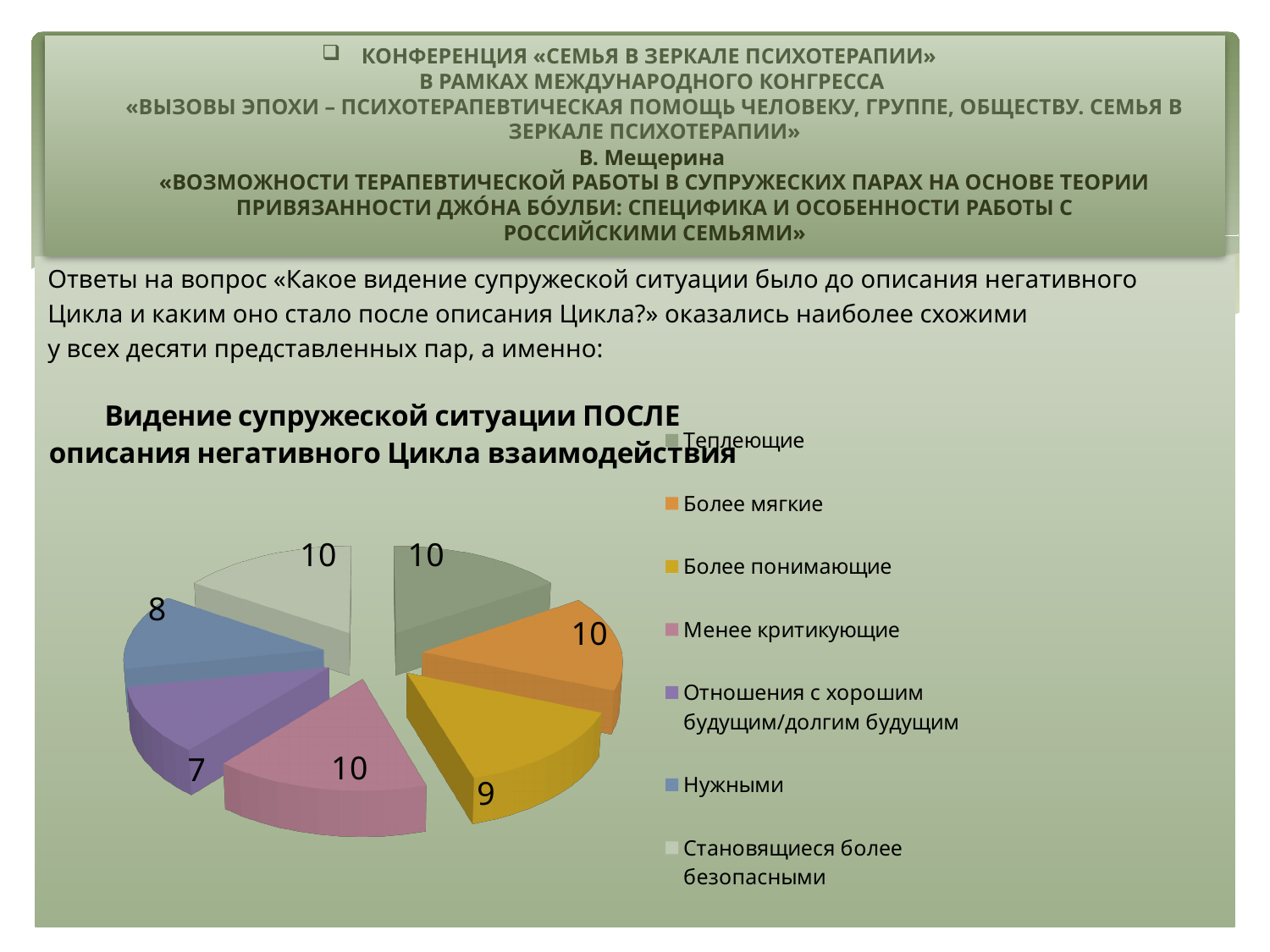
What is the total of all the values shown in the pie chart? 64 What is the title of the pie chart? Видение супружеской ситуации ПОСЛЕ описания негативного Цикла взаимодействия What kind of chart is shown on the slide? pie chart Which is larger: the value for «Нужными» or the value for «Более понимающие»? Более понимающие Which category has the smallest slice in the pie chart? Отношения с хорошим будущим/долгим будущим What is the difference between the values for «Более мягкие» and «Отношения с хорошим будущим/долгим будущим»? 3 What is the value for «Становящиеся более безопасными» in the pie chart? 10 What is the value for «Отношения с хорошим будущим/долгим будущим» in the pie chart? 7 What is the value for «Более понимающие» in the pie chart? 9 What is the value for «Нужными» in the pie chart? 8 What is the value for «Теплеющие» in the pie chart? 10 How many slices does the pie chart have? 7